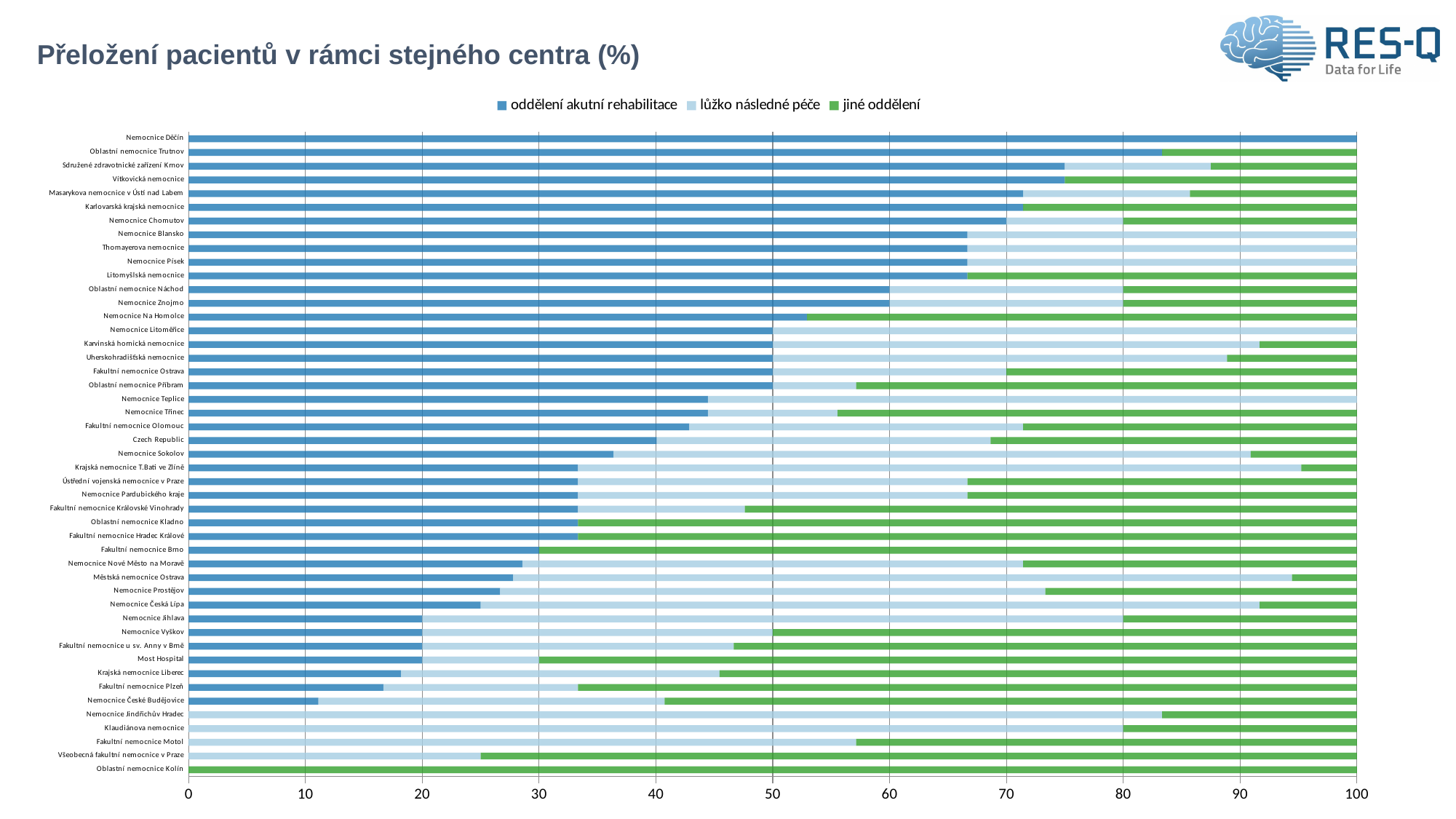
Which is larger, the oddělení akutní rehabilitace value for Nemocnice Děčín or for Oblastní nemocnice Kolín? Nemocnice Děčín What is the value for oddělení akutní rehabilitace for Nemocnice Chomutov? 70 Which hospital has the highest value for oddělení akutní rehabilitace? Nemocnice Děčín What are the three series named in the legend? oddělení akutní rehabilitace, lůžko následné péče, jiné oddělení What is the value for jiné oddělení for Oblastní nemocnice Kolín? 100 What kind of chart is shown on the slide? Stacked bar chart Is the value for oddělení akutní rehabilitace for Nemocnice Na Homolce greater or less than 50? greater What is the value for oddělení akutní rehabilitace for Nemocnice Děčín? 100 How many series does the legend list? 3 What is the title of the chart? Přeložení pacientů v rámci stejného centra (%) Is the value for oddělení akutní rehabilitace for Nemocnice České Budějovice greater or less than 20? less